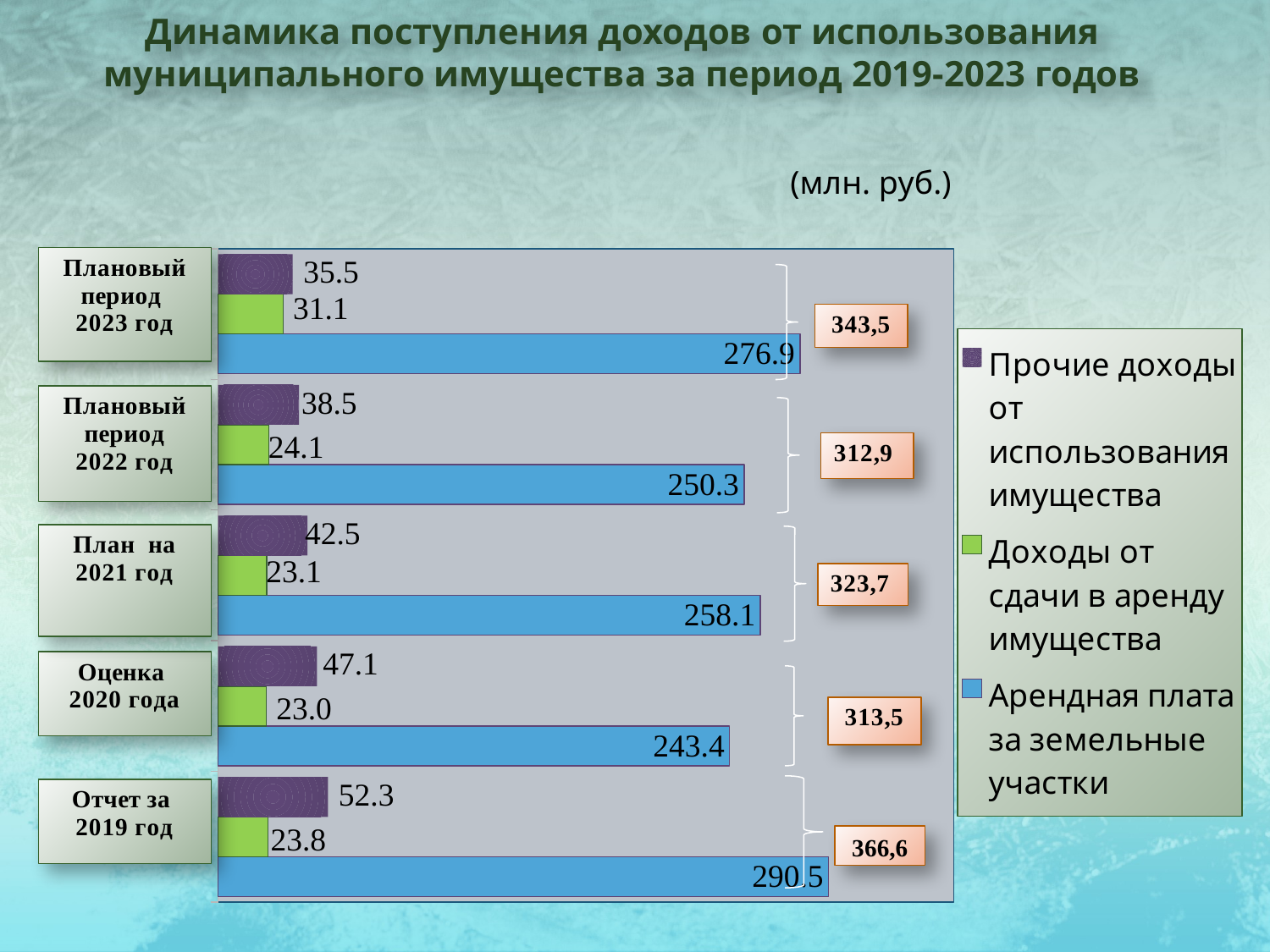
What unit of measurement is indicated on the slide for the chart values? млн. руб. Which is larger: "Доходы от сдачи в аренду имущества" for "Плановый период 2023 год" or for "План на 2021 год"? Плановый период 2023 год What is the value of "Доходы от сдачи в аренду имущества" for "Оценка 2020 года"? 23.0 What kind of chart is shown on the slide? Bar chart What total is shown in the box for "Отчет за 2019 год"? 366,6 What is the difference between the "Арендная плата за земельные участки" values for "Плановый период 2023 год" and "Плановый период 2022 год"? 26.6 How many series does the legend list? 3 What is the value of "Арендная плата за земельные участки" for "Отчет за 2019 год"? 290.5 What is the value of "Прочие доходы от использования имущества" for "Плановый период 2023 год"? 35.5 Which period has the highest value for "Прочие доходы от использования имущества"? Отчет за 2019 год Which period has the lowest value for "Арендная плата за земельные участки"? Оценка 2020 года How many periods (categories) are shown in the chart? 5